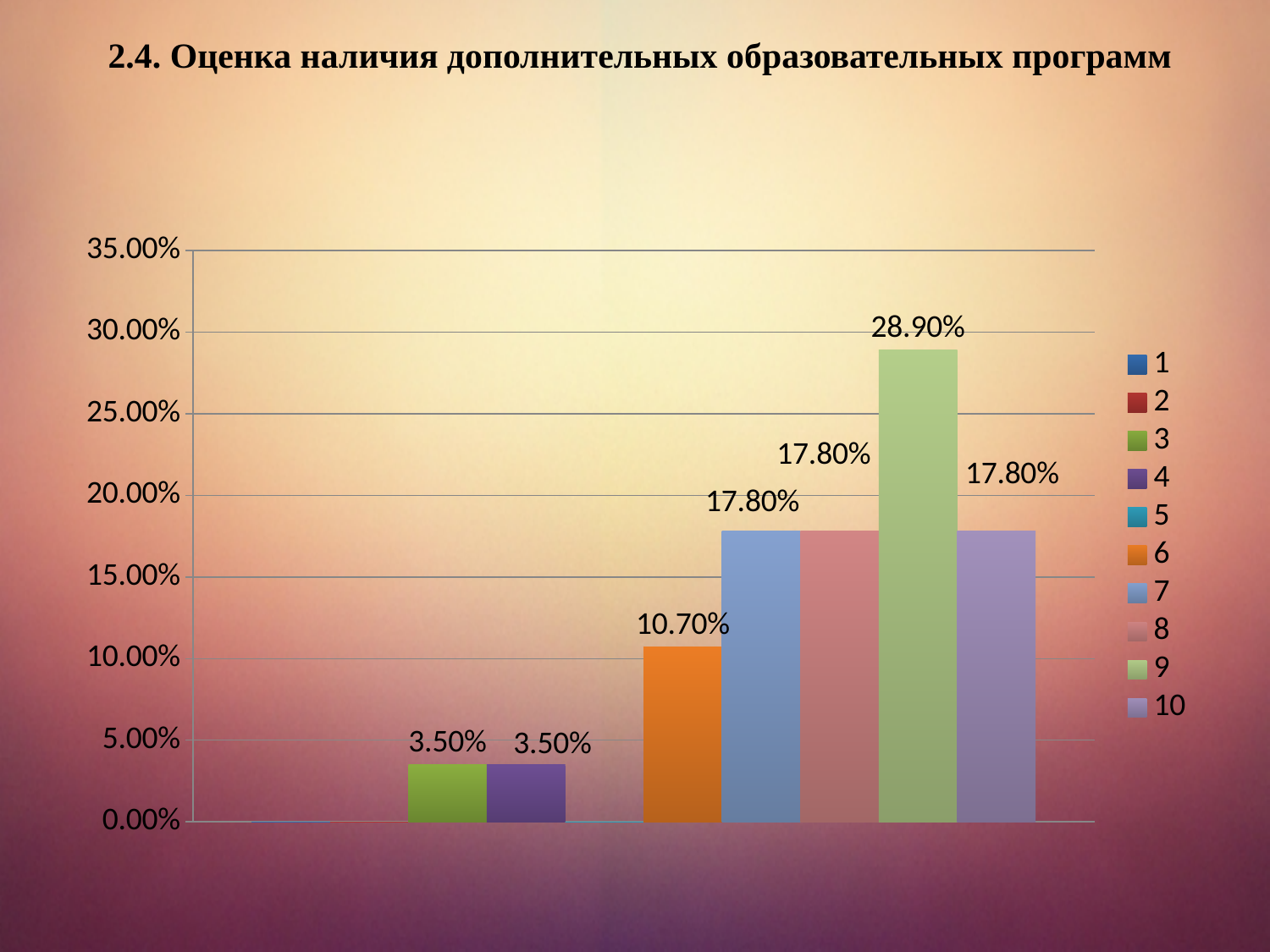
Is the value for series 9 greater or less than 25.00%? greater What is the value for series 3? 3.50% Which is larger, the value for series 6 or the value for series 4? 6 What is the title of the slide? 2.4. Оценка наличия дополнительных образовательных программ Which series has the highest value? 9 What is the difference between the values for series 9 and series 6? 18.20% What is the value for series 9? 28.90% How many series does the legend list? 10 What is the value for series 7? 17.80% What is the value for series 6? 10.70% What kind of chart is shown on the slide? bar chart What is the difference between the values for series 9 and series 10? 11.10%